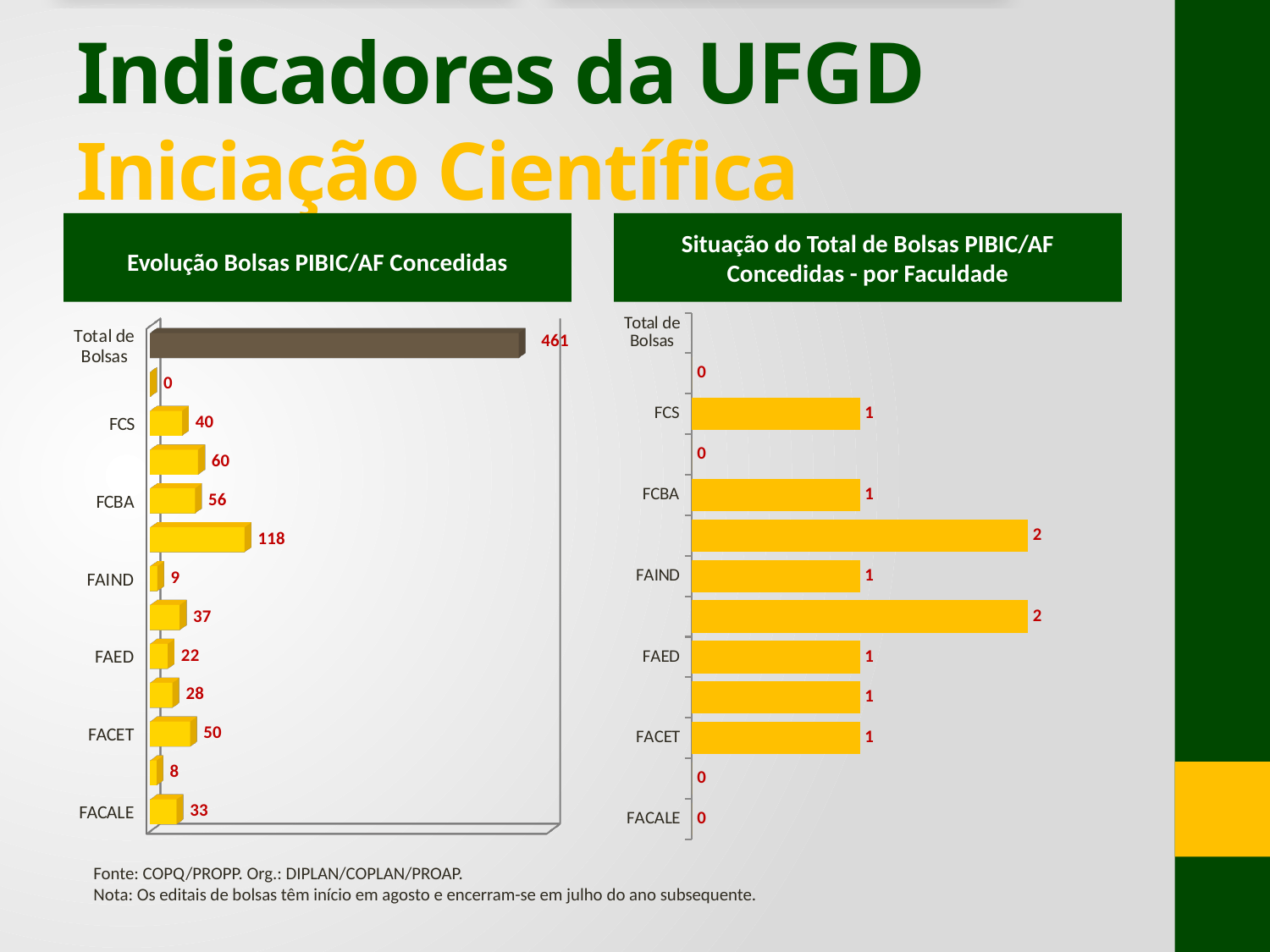
In the chart titled "Evolução Bolsas PIBIC/AF Concedidas", what is the difference between the values for FCBA and FCS? 16 In the chart titled "Evolução Bolsas PIBIC/AF Concedidas", what is the value for FACET? 50 In the chart titled "Evolução Bolsas PIBIC/AF Concedidas", what is the value for FAIND? 9 In the chart titled "Evolução Bolsas PIBIC/AF Concedidas", what is the value for Total de Bolsas? 461 In the chart titled "Situação do Total de Bolsas PIBIC/AF Concedidas - por Faculdade", which is larger, the value for FAED or the value for FACALE? FAED In the chart titled "Evolução Bolsas PIBIC/AF Concedidas", which is larger, the value for FACET or the value for FACALE? FACET In the chart titled "Evolução Bolsas PIBIC/AF Concedidas", which of FCS, FCBA, FAIND, FAED, FACET and FACALE has the lowest value? FAIND What is the title of the chart on the left side of the slide? Evolução Bolsas PIBIC/AF Concedidas In the chart titled "Evolução Bolsas PIBIC/AF Concedidas", what is the value for FCBA? 56 What kind of chart is the one titled "Evolução Bolsas PIBIC/AF Concedidas"? Bar chart In the chart titled "Situação do Total de Bolsas PIBIC/AF Concedidas - por Faculdade", what is the value for FCS? 1 In the chart titled "Situação do Total de Bolsas PIBIC/AF Concedidas - por Faculdade", what is the value for FACALE? 0